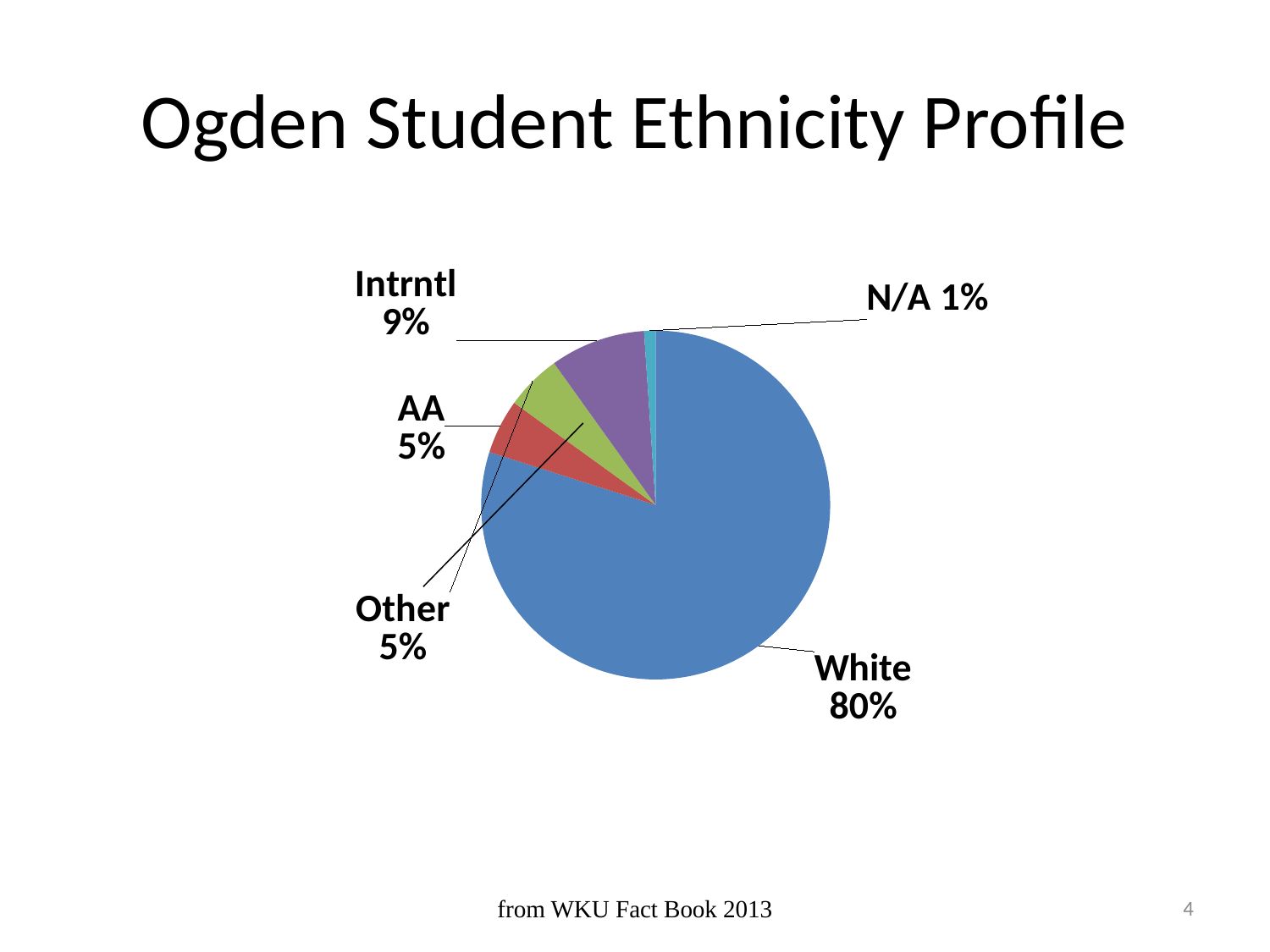
What is the title of the slide containing the pie chart? Ogden Student Ethnicity Profile Which category has the smallest slice of the pie? N/A What share of the pie does AA represent? 5% What kind of chart is shown on the slide? pie chart What is the difference in percentage points between Intrntl and N/A? 8 What share of the pie does White represent? 80% How many slices does the pie chart have? 5 What share of the pie does N/A represent? 1% Which category has the largest slice of the pie? White What is the difference in percentage points between White and Intrntl? 71 Which is larger, the Intrntl slice or the AA slice? Intrntl